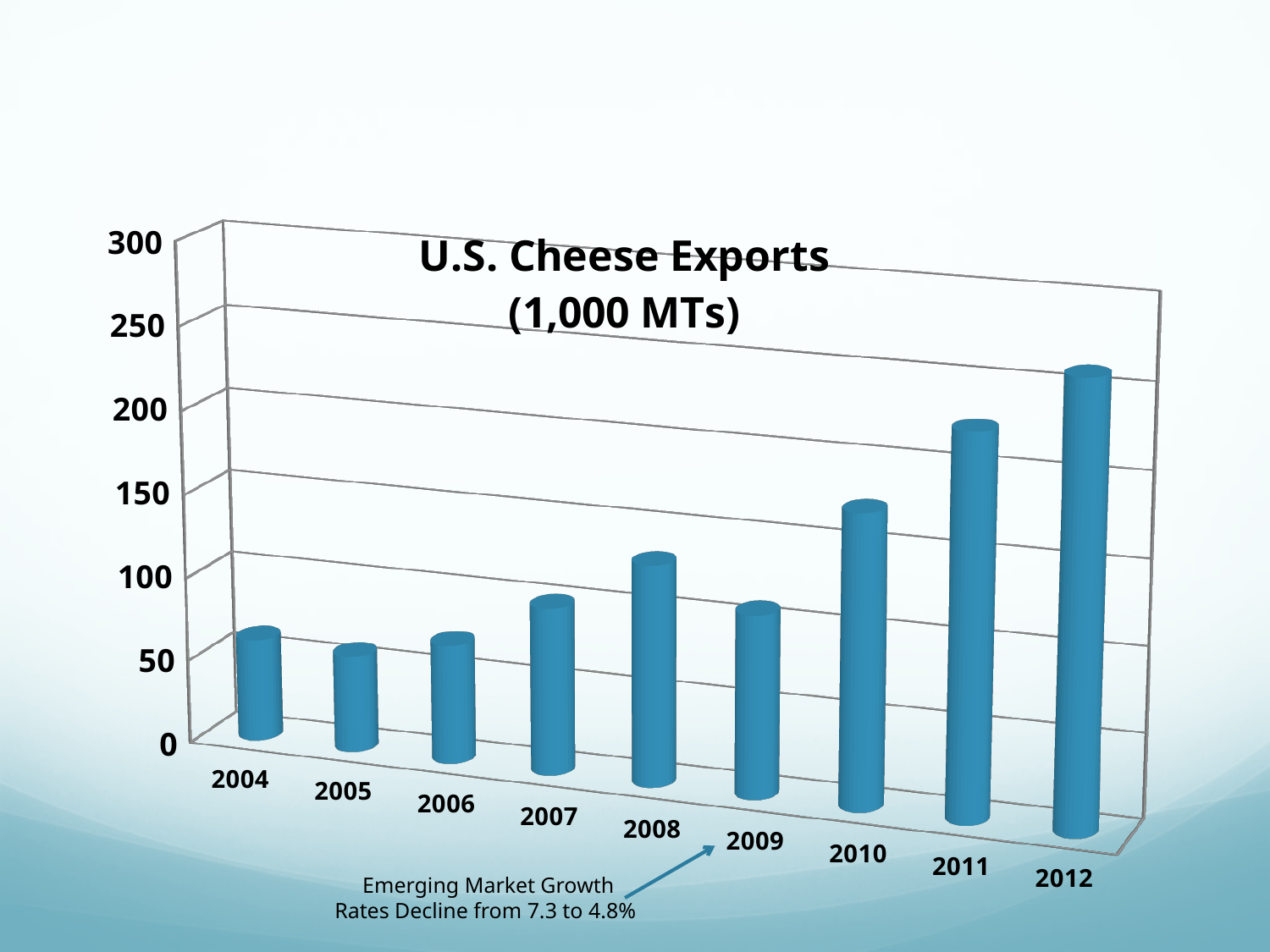
Is the value for 2011 greater or less than 150? greater Overall, do U.S. cheese exports rise or fall from 2004 to 2012? Rise What kind of chart is shown on the slide? Bar chart Which year has the larger value, 2011 or 2008? 2011 Which year does the annotation about emerging market growth rates declining from 7.3 to 4.8% point to? 2009 How many years are plotted on the chart? 9 What is the title of the chart? U.S. Cheese Exports (1,000 MTs) Which year has the highest value for U.S. cheese exports? 2012 Is the value for 2012 greater or less than 200? greater Which year has the larger value, 2010 or 2009? 2010 Is the value for 2005 greater or less than 100? less